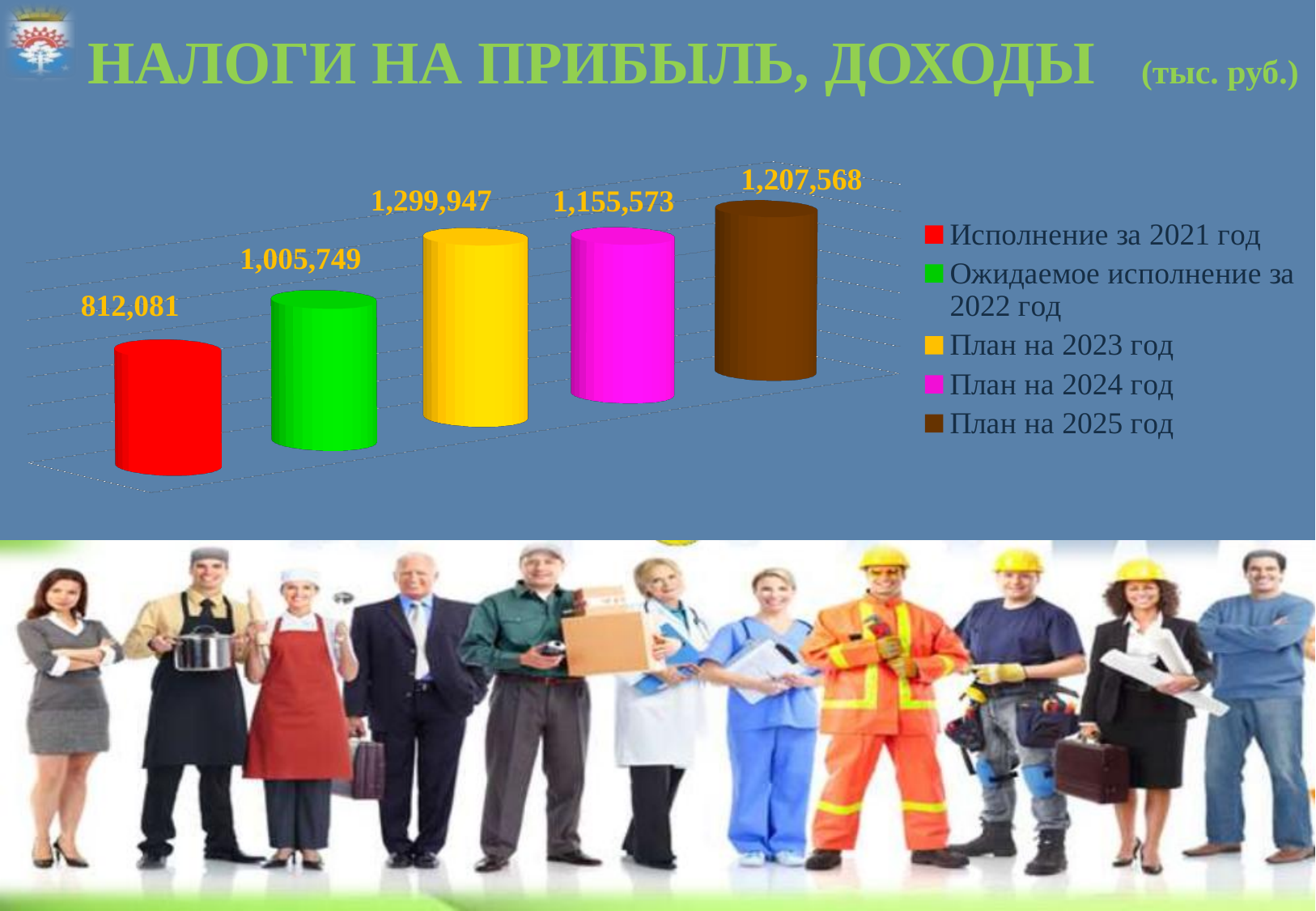
What is the value for План на 2025 год? 1,207,568 What kind of chart is shown on the slide? Bar chart Which series has the highest value? План на 2023 год Which series has the lowest value? Исполнение за 2021 год How many series does the legend list? 5 What is the difference between the values for План на 2023 год and План на 2024 год? 144,374 What is the value for Исполнение за 2021 год? 812,081 What unit is given in the chart title? тыс. руб. Which is larger, the value for План на 2024 год or the value for План на 2025 год? План на 2025 год What is the value for Ожидаемое исполнение за 2022 год? 1,005,749 What is the value for План на 2023 год? 1,299,947 What is the difference between the values for Ожидаемое исполнение за 2022 год and Исполнение за 2021 год? 193,668